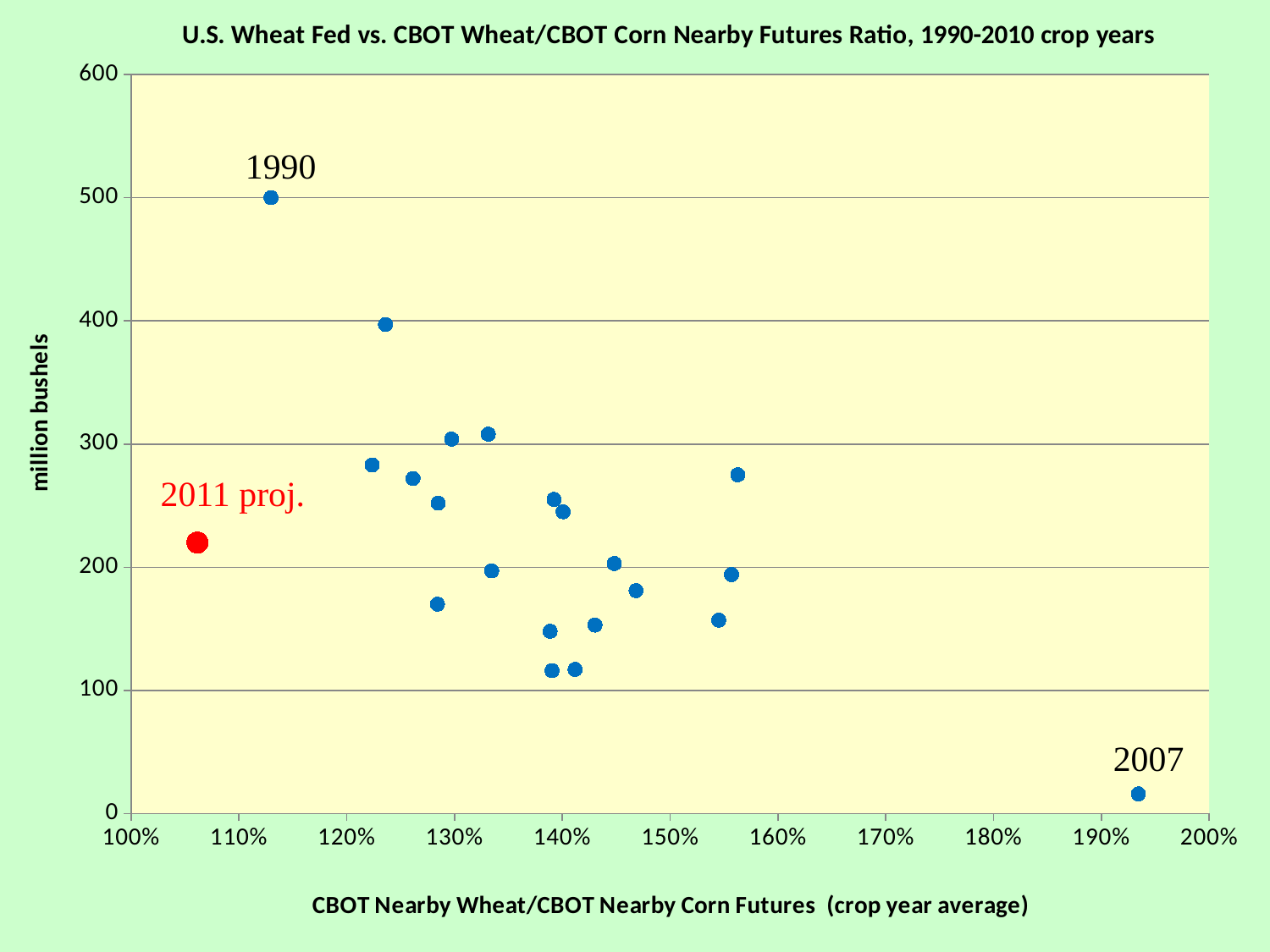
Is the million bushels value for the 2007 point greater or less than 100? less How many points on the chart are labeled with a year? 3 Is the million bushels value for the 2011 proj. point greater or less than 300? less Which has the larger million bushels value, the 2011 proj. point or the 2007 point? 2011 proj. What kind of chart is shown on the slide? scatter chart Is the million bushels value for the 1990 point greater or less than 400? greater Which labeled point has the highest value in million bushels? 1990 What is the title of the chart? U.S. Wheat Fed vs. CBOT Wheat/CBOT Corn Nearby Futures Ratio, 1990-2010 crop years Which labeled point has the lowest value in million bushels? 2007